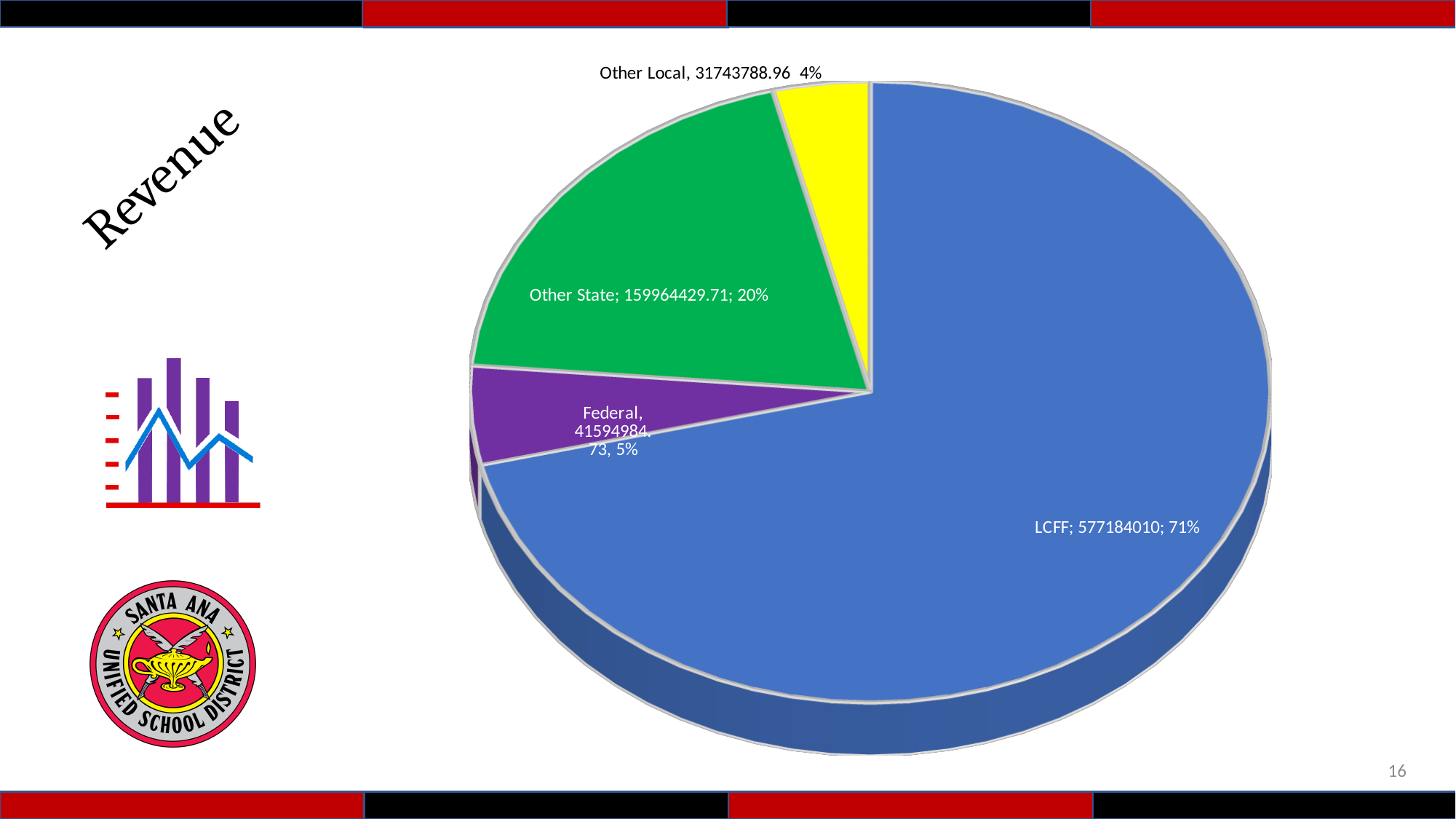
What is the title of the slide containing the pie chart? Revenue What is the value shown for Other State? 159964429.71 How many slices does the pie chart have? 4 What share of the pie does Other State represent? 20% Which category has the smallest slice of the pie? Other Local What share of the pie does LCFF represent? 71% Which category has the largest slice of the pie? LCFF What is the value shown for LCFF? 577184010 What is the value shown for Federal? 41594984.73 What kind of chart is shown on the slide? pie chart What is the value shown for Other Local? 31743788.96 Which is larger, the value for Federal or the value for Other Local? Federal